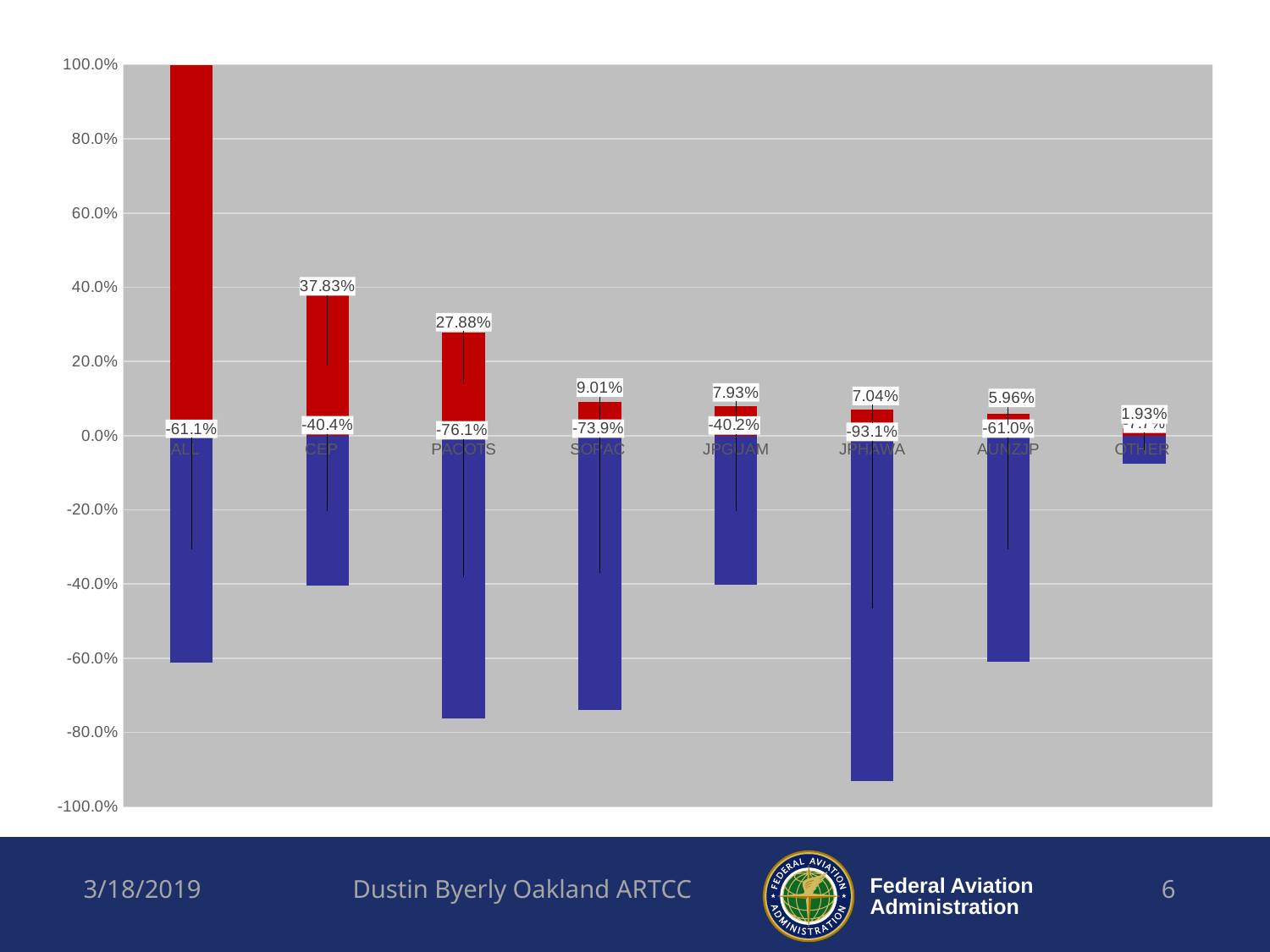
Which category has the tallest red bar? ALL What is the difference between the red bar values for CEP and PACOTS? 9.95 percentage points How many categories are shown on the x axis of the chart? 8 What is the value of the red bar for CEP? 37.83% What kind of chart is shown on the slide? bar chart Do the red bar values rise or fall from CEP to OTHER along the x axis? fall Which category has the lowest (most negative) blue bar? JPHAWA What is the value of the red bar for PACOTS? 27.88% What is the value of the blue bar for JPHAWA? -93.1% What is the value of the blue bar for ALL? -61.1% Is the red bar for ALL greater or less than 80.0%? greater What is the value of the red bar for OTHER? 1.93%